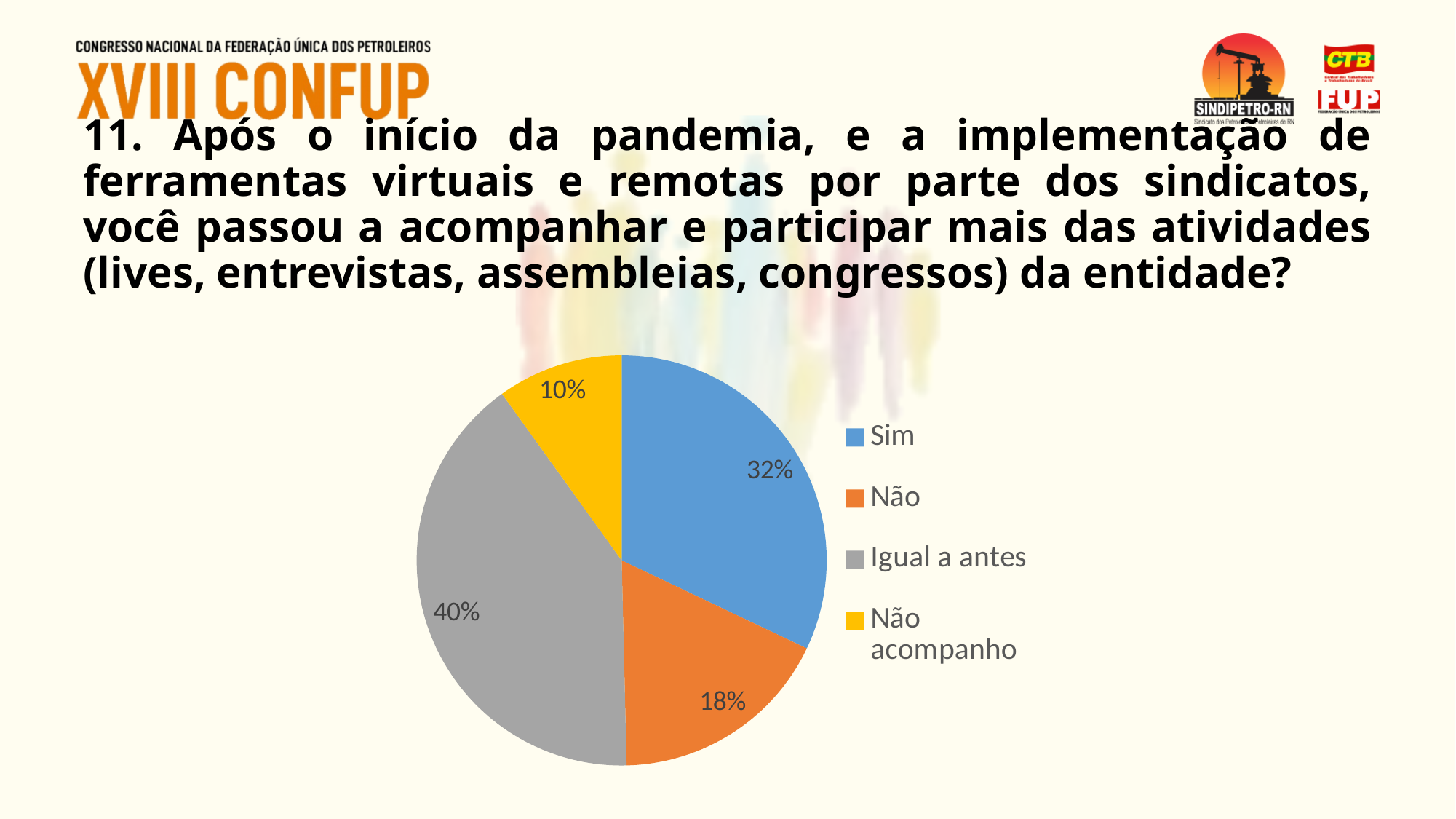
What colour is the slice for "Igual a antes"? grey How many categories does the pie chart have? 4 What share of the pie does "Sim" represent? 32% What is the difference in percentage points between "Sim" and "Não"? 14 What kind of chart is shown on the slide? pie chart What share of the pie does "Não" represent? 18% What share of the pie does "Igual a antes" represent? 40% Which category has the smallest slice of the pie? Não acompanho Which is larger, the slice for "Não" or the slice for "Não acompanho"? Não Which category has the largest slice of the pie? Igual a antes What is the difference in percentage points between "Igual a antes" and "Sim"? 8